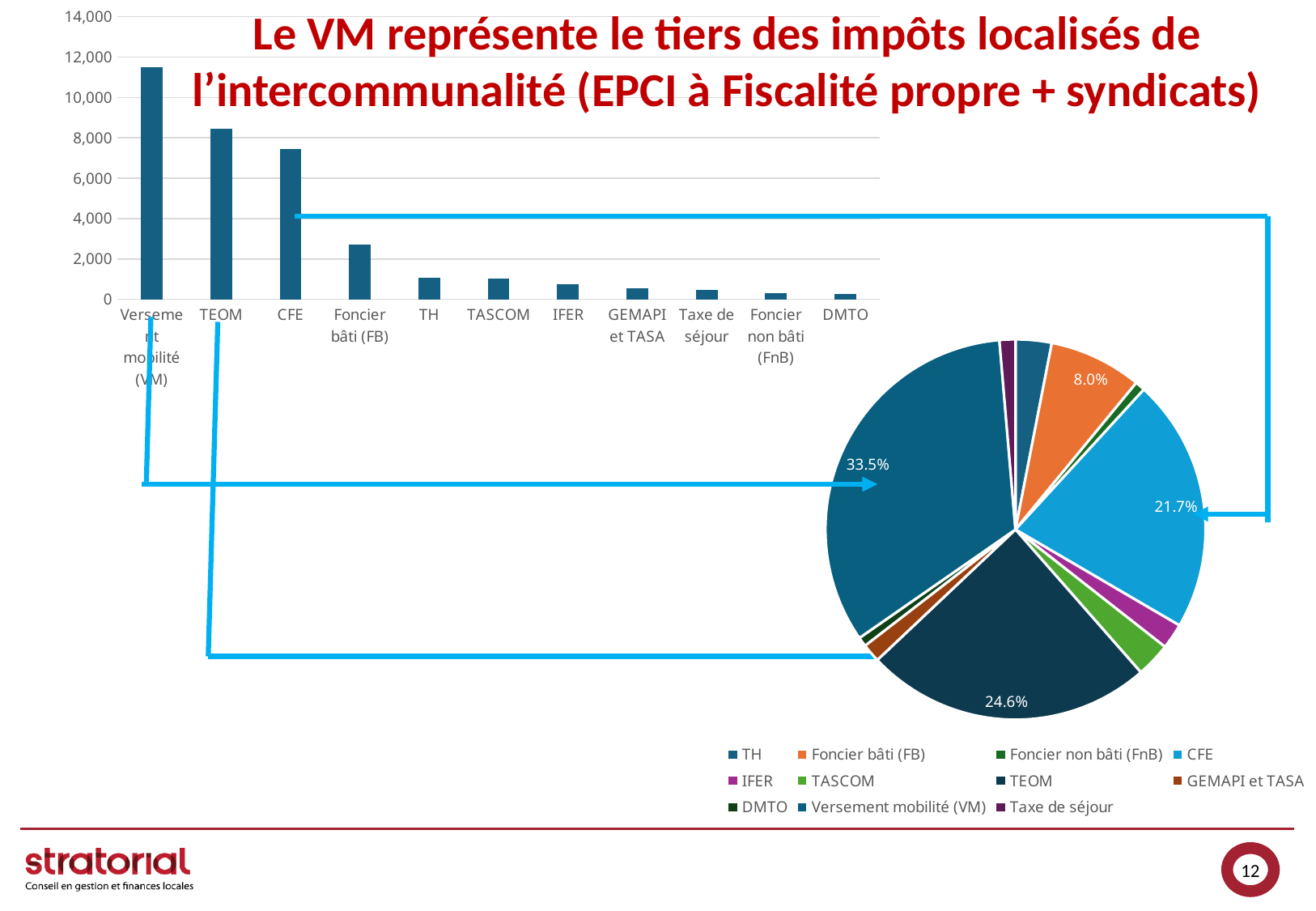
What kind of chart is the chart in the top left of the slide? bar chart In the bar chart, is the value for CFE greater or less than 8,000? less In the bar chart, is the value for Foncier bâti (FB) greater or less than 2,000? greater In the bar chart, how many categories are shown on the x axis? 11 In the bar chart, which bar is taller, TEOM or CFE? TEOM What kind of chart is the chart in the bottom right of the slide? pie chart In the pie chart, what is the difference in percentage points between the CFE slice (21.7%) and the Foncier bâti (FB) slice (8.0%)? 13.7 percentage points How many entries does the pie chart's legend list? 11 In the bar chart, is the value for Versement mobilité (VM) greater or less than 10,000? greater In the pie chart, what share is labelled on the Versement mobilité (VM) slice? 33.5% In the bar chart, which category has the highest bar? Versement mobilité (VM) In the pie chart, what share is labelled on the TEOM slice? 24.6%